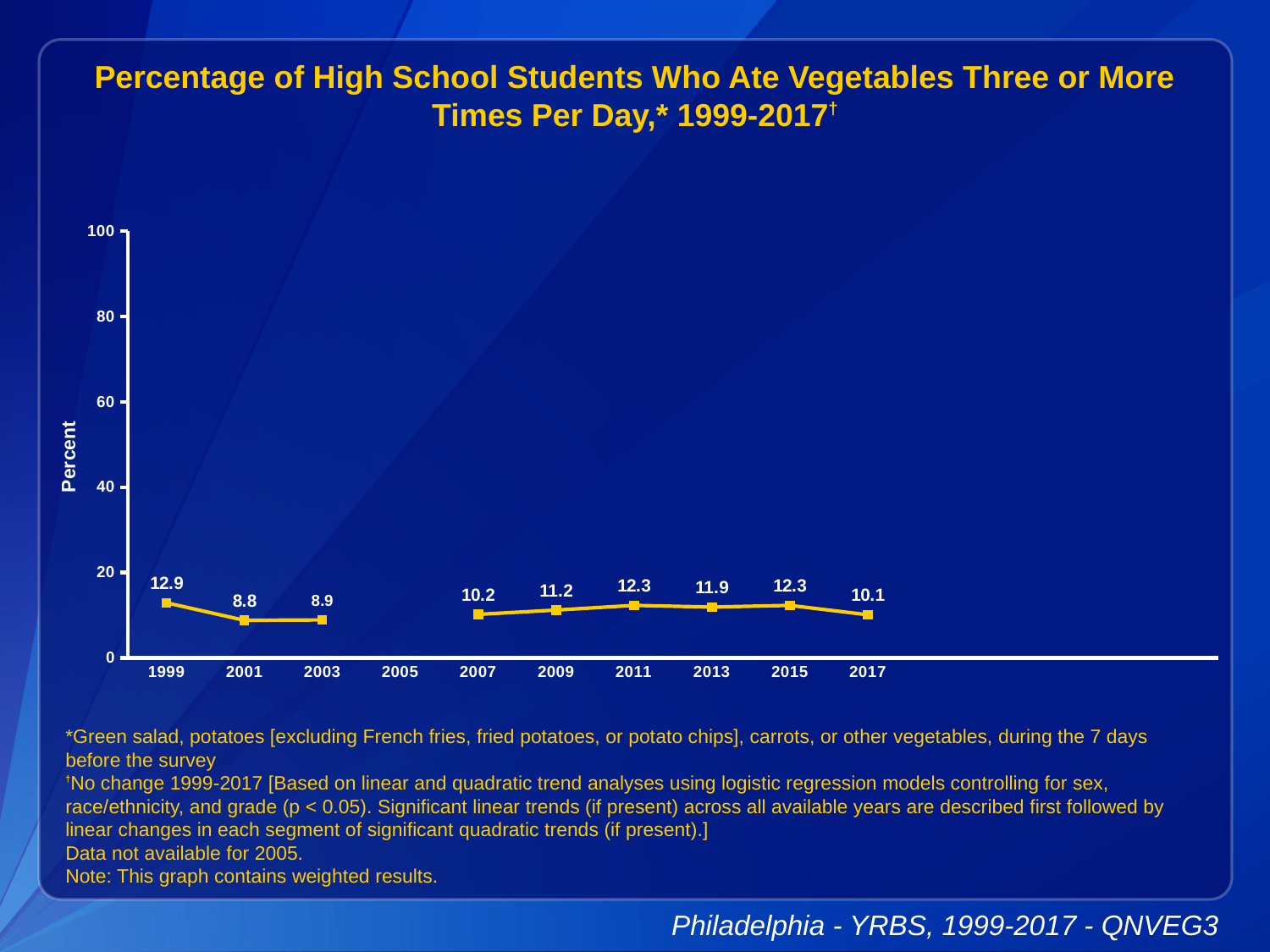
Which year has the lowest plotted value? 2001 What is the value plotted for 2017? 10.1 Which year on the x axis has no data point plotted? 2005 What kind of chart is shown on the slide? line chart How many years have a data point plotted on the chart? 9 What percentage of high school students ate vegetables three or more times per day in 1999? 12.9 What is the value plotted for 2009? 11.2 What is the difference between the values for 1999 and 2001? 4.1 Is the value for 2013 greater or less than 20? less Which is larger, the value for 2007 or the value for 2011? 2011 Which year has the highest plotted value? 1999 What is the label on the y axis? Percent